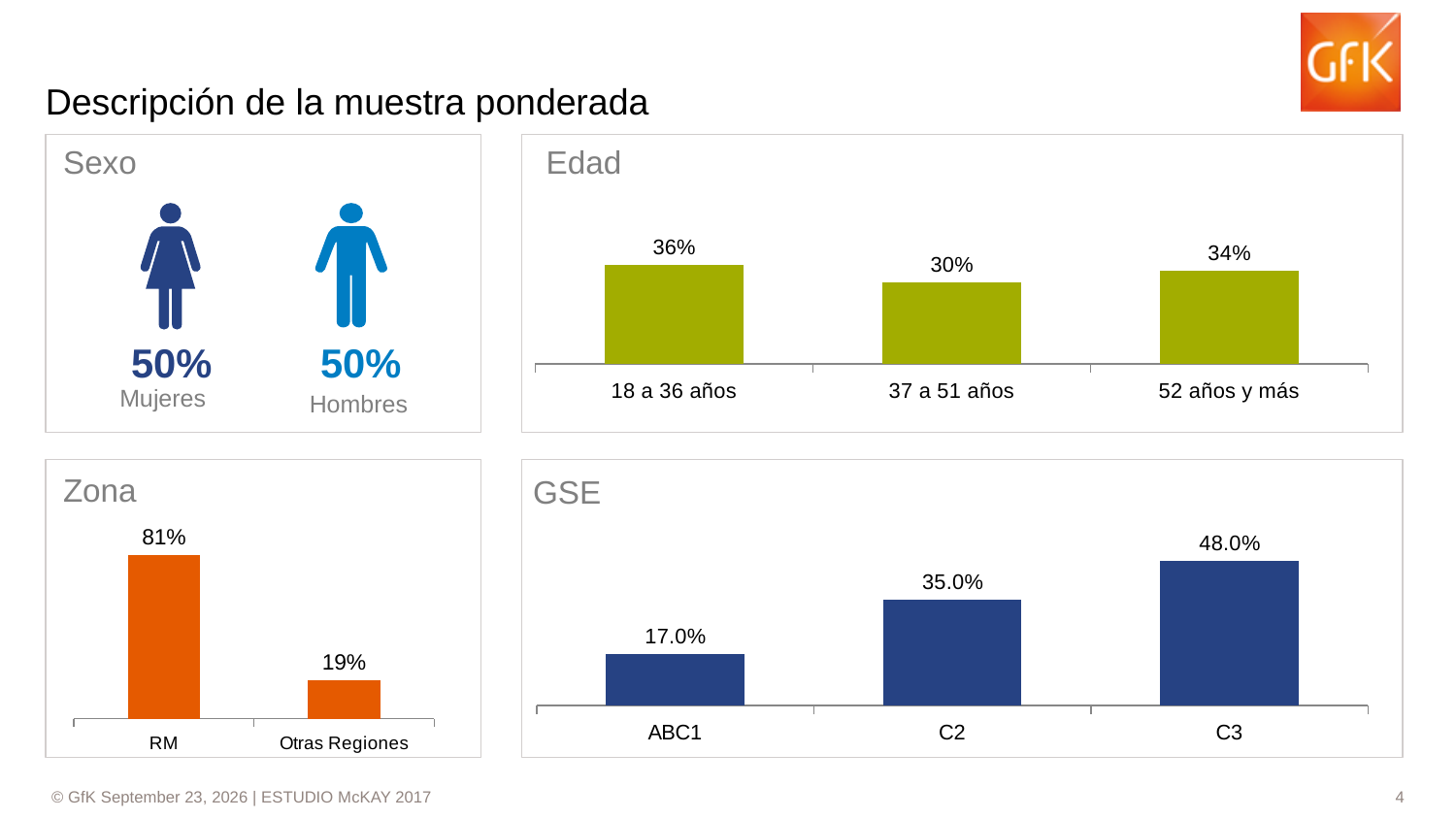
In the Zona chart, which category is higher, RM or Otras Regiones? RM In the GSE chart, do the values rise or fall from ABC1 to C3? rise In the Edad chart, what is the difference between 18 a 36 años and 37 a 51 años? 6% What kind of chart is the Zona chart? bar chart In the GSE chart, which category has the highest value? C3 In the Edad chart, how many age categories are shown? 3 In the GSE chart, what is the difference between C3 and ABC1? 31.0% In the GSE chart, what is the value for C2? 35.0% In the Edad chart, which age group has the lowest value? 37 a 51 años In the Edad chart, what is the value for 18 a 36 años? 36% In the Zona chart, what is the value for RM? 81% In the Zona chart, what is the difference between RM and Otras Regiones? 62%